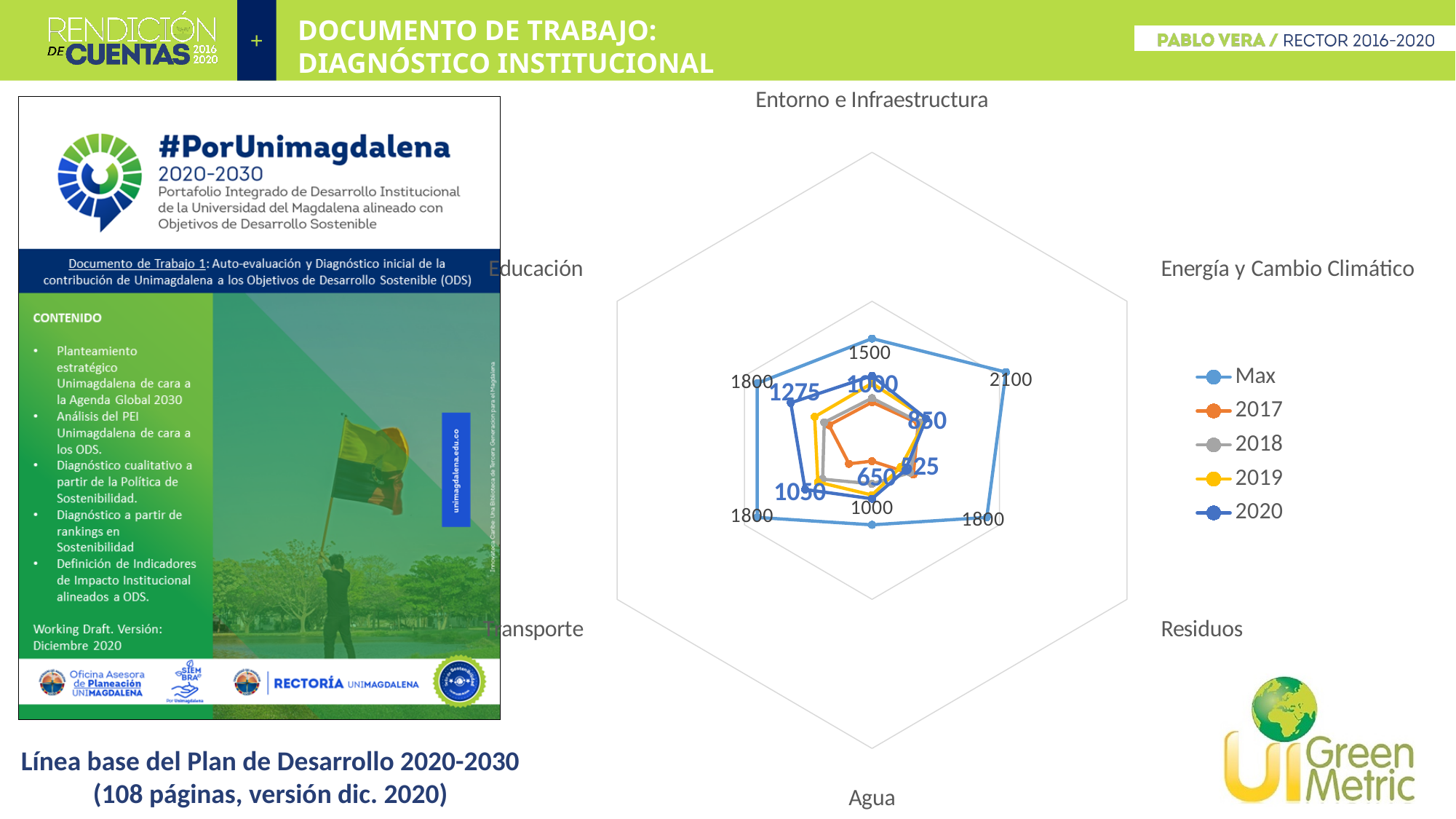
What is the Max value for Agua? 1000 For the Max series, which category has the highest value? Energía y Cambio Climático How many categories (axes) does the radar chart have? 6 How many series does the chart legend list? 5 What is the difference between the Max value and the 2020 value for Entorno e Infraestructura? 500 For the 2020 series, which category has the lowest value? Residuos What is the Max value for Energía y Cambio Climático? 2100 For 2020, which is larger: the value for Energía y Cambio Climático or the value for Agua? Energía y Cambio Climático Which series is listed first in the chart legend? Max What is the 2020 value for Residuos? 525 What kind of chart is shown on the slide? Radar chart What is the 2020 value for Educación? 1275